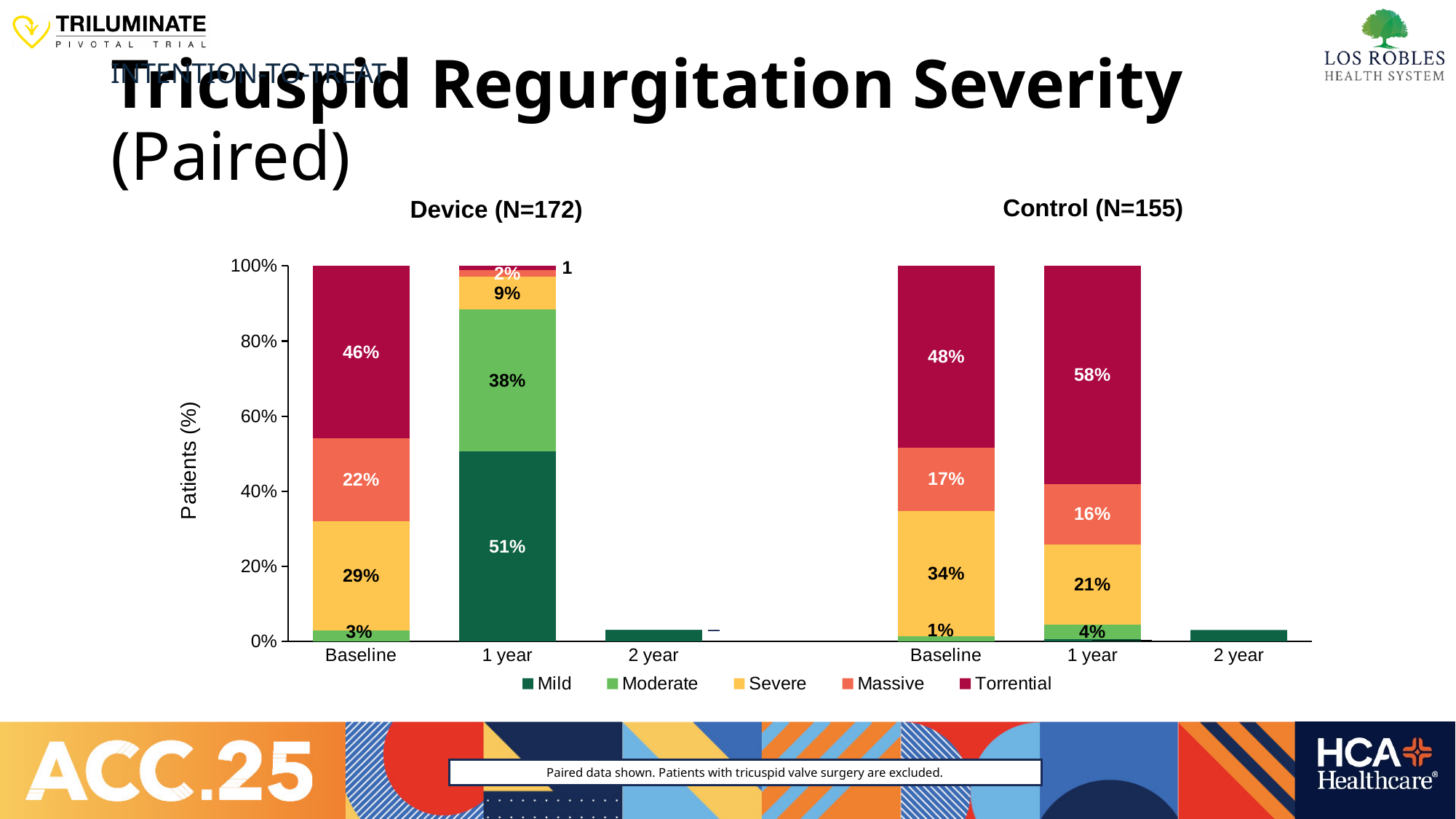
Which is larger: the Moderate share in the Device group at 1 year or the Severe share in the Control group at 1 year? Moderate share in the Device group at 1 year What percentage of Device patients had Torrential tricuspid regurgitation at Baseline? 46% What type of chart is shown on the slide? Stacked bar chart What percentage of Device patients had Mild tricuspid regurgitation at 1 year? 51% Which severity category is shown in dark green in the legend? Mild What percentage of Control patients had Severe tricuspid regurgitation at Baseline? 34% How many severity categories does the legend list? 5 What percentage of Device patients had Severe tricuspid regurgitation at 1 year? 9% Which severity category makes up the largest segment of the Control 1 year bar? Torrential What percentage of Control patients had Torrential tricuspid regurgitation at 1 year? 58% By how many percentage points did the Torrential share in the Control group change from Baseline to 1 year? 10% Is the total height of the Device 2 year bar greater or less than 20%? less